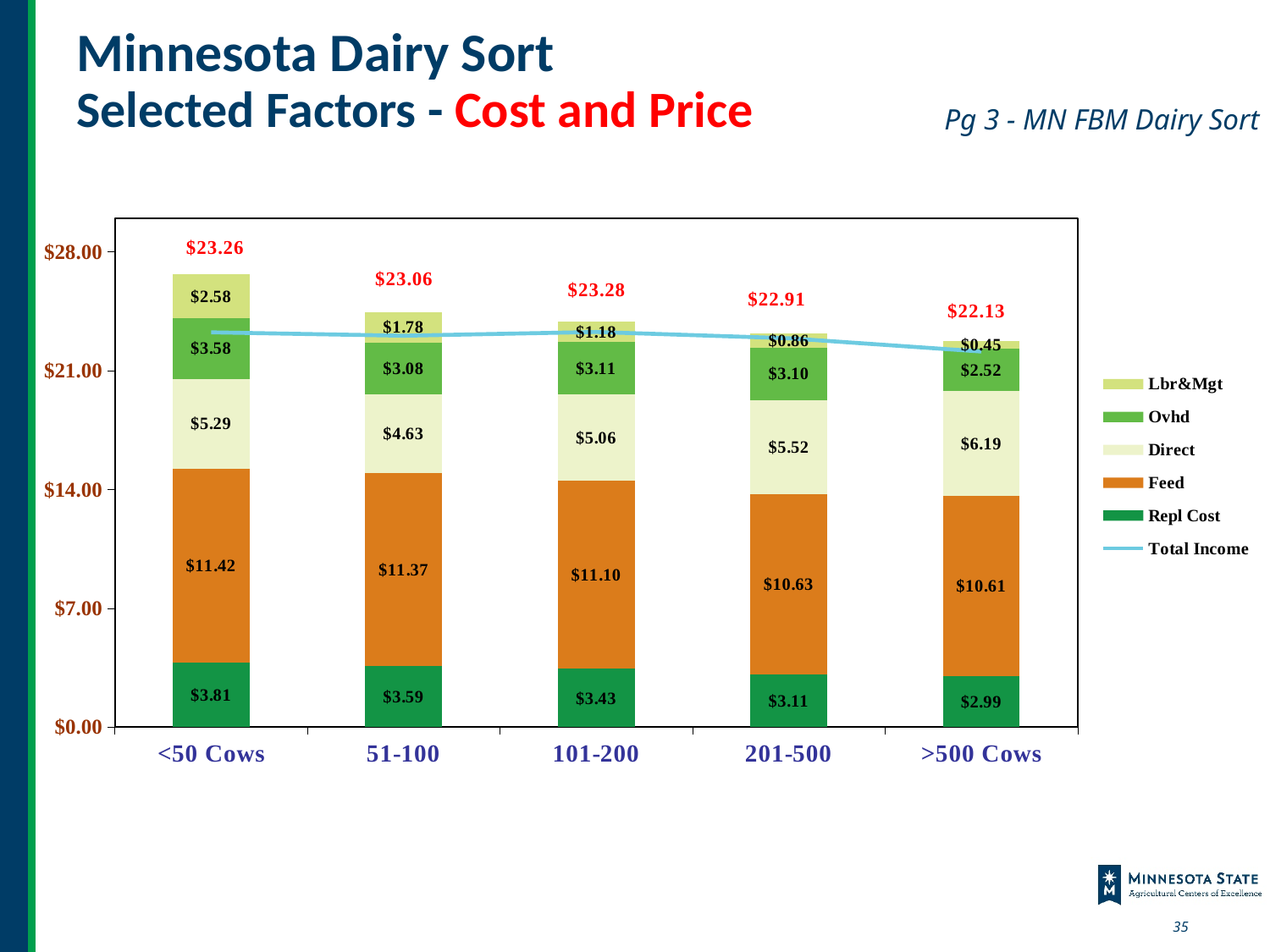
Which category has the lowest Total Income value? >500 Cows What is the Lbr&Mgt value for the >500 Cows category? $0.45 What is the difference between the Feed value for <50 Cows and the Feed value for >500 Cows? $0.81 Which category has the highest Direct value? >500 Cows How many herd-size categories are shown on the x axis? 5 How many series does the legend list? 6 What is the Total Income value for the 201-500 category? $22.91 What is the Feed value for the 101-200 category? $11.10 Which has the larger Direct value, 51-100 or 201-500? 201-500 Which category has the lowest Repl Cost value? >500 Cows Does the Feed value rise or fall as herd size increases along the x axis? Falls What kind of chart is used to show the cost components? Stacked bar chart